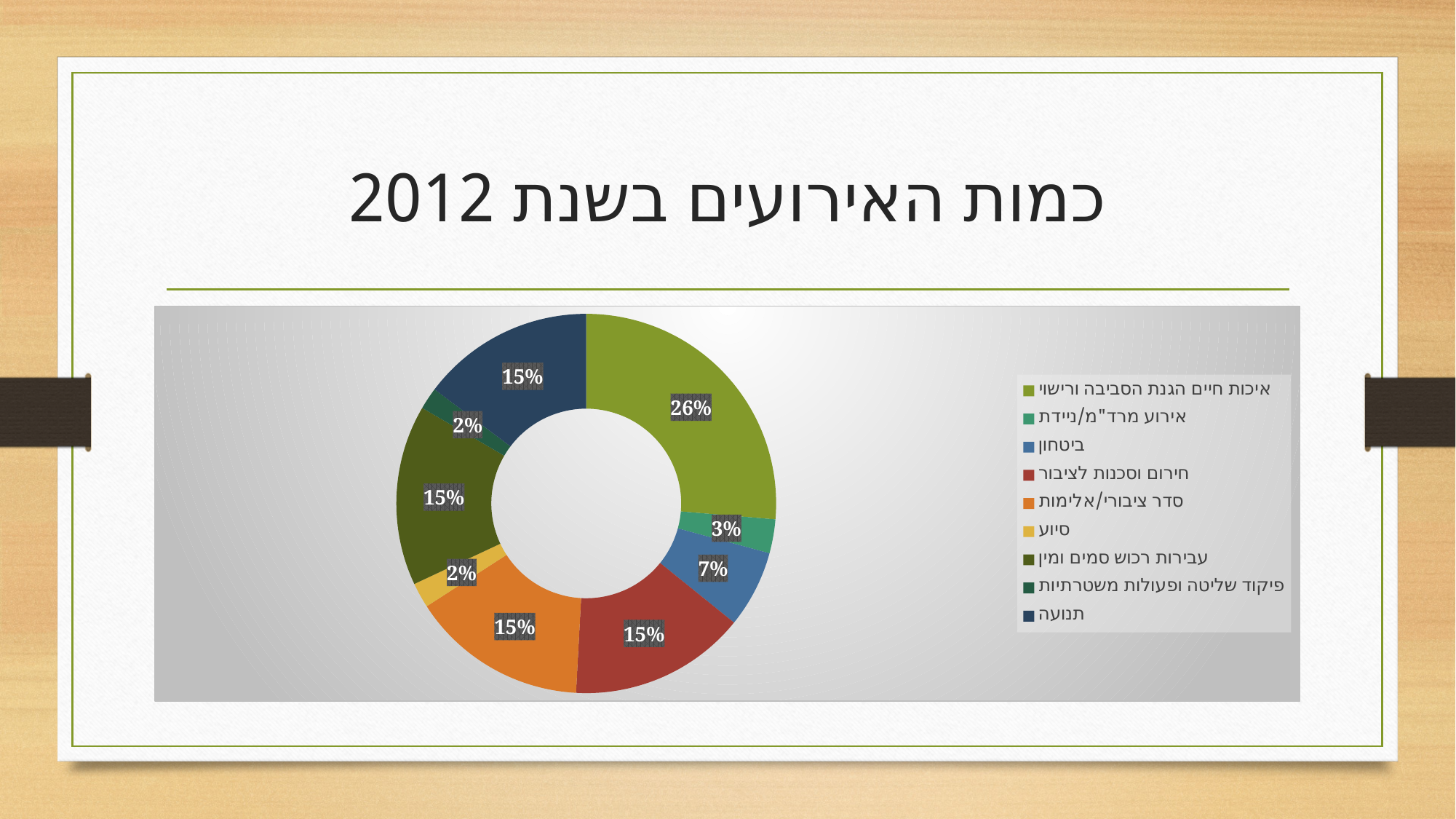
What is the combined share of חירום וסכנות לציבור and סדר ציבורי/אלימות? 30% What percentage of events is attributed to ביטחון? 7% What kind of chart is shown on the slide? Doughnut (pie) chart What percentage of events is attributed to איכות חיים הגנת הסביבה ורישוי? 26% Which category has the largest share of events? איכות חיים הגנת הסביבה ורישוי What is the difference in percentage points between איכות חיים הגנת הסביבה ורישוי and ביטחון? 19 percentage points What percentage of events is attributed to תנועה? 15% What percentage of events is attributed to סיוע? 2% How many categories does the chart show? 9 What is the title of the slide? כמות האירועים בשנת 2012 Which is larger, the share for ביטחון or the share for אירוע מרד"מ/ניידת? ביטחון What percentage of events is attributed to אירוע מרד"מ/ניידת? 3%